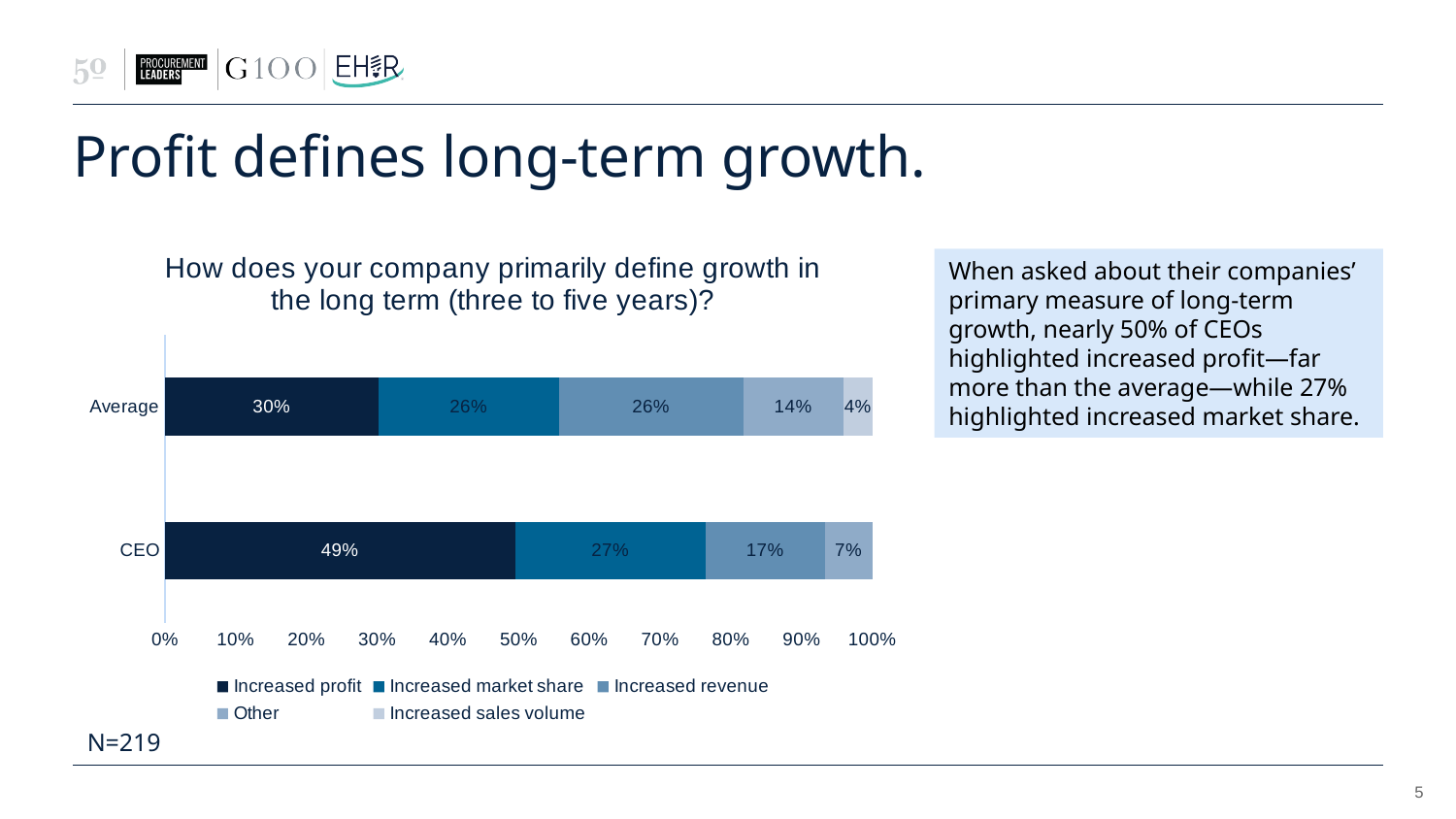
Which segment is the largest in the CEO bar? Increased profit How many percentage points higher is the CEO value for Increased profit than the Average value? 19 percentage points Which group has the larger value for Increased revenue, CEO or Average? Average How many series does the legend list? 5 What percentage of CEOs chose Increased market share? 27% What kind of chart is shown on the slide? Stacked bar chart What is the CEO value for Other? 7% What is the Average value for Increased profit? 30% How many categories (bars) are shown in the chart? 2 What is the Average value for Increased sales volume? 4% What percentage of CEOs chose Increased profit? 49% What is the Average value for Increased revenue? 26%